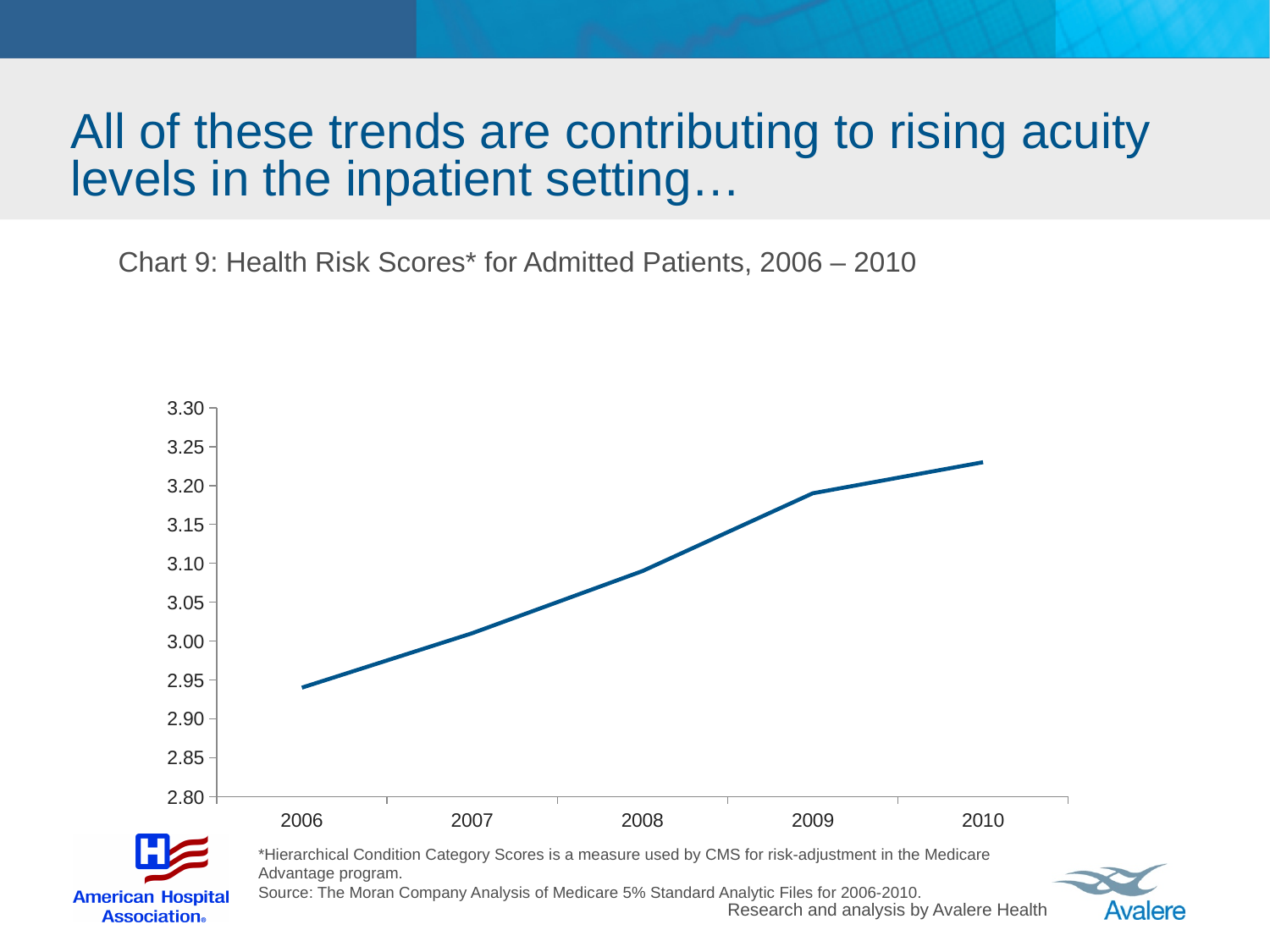
Is the health risk score for 2010 greater or less than 3.25? less Is the health risk score for 2008 greater or less than 3.05? greater Is the health risk score for 2006 greater or less than 2.90? greater Which year has the lowest health risk score? 2006 Do the health risk scores rise or fall from 2006 to 2010? rise How many years are plotted on the x axis of the chart? 5 Which year has a higher health risk score, 2007 or 2009? 2009 Which year has the highest health risk score? 2010 What is the title of the chart on the slide? Chart 9: Health Risk Scores* for Admitted Patients, 2006 – 2010 What kind of chart is Chart 9? line chart